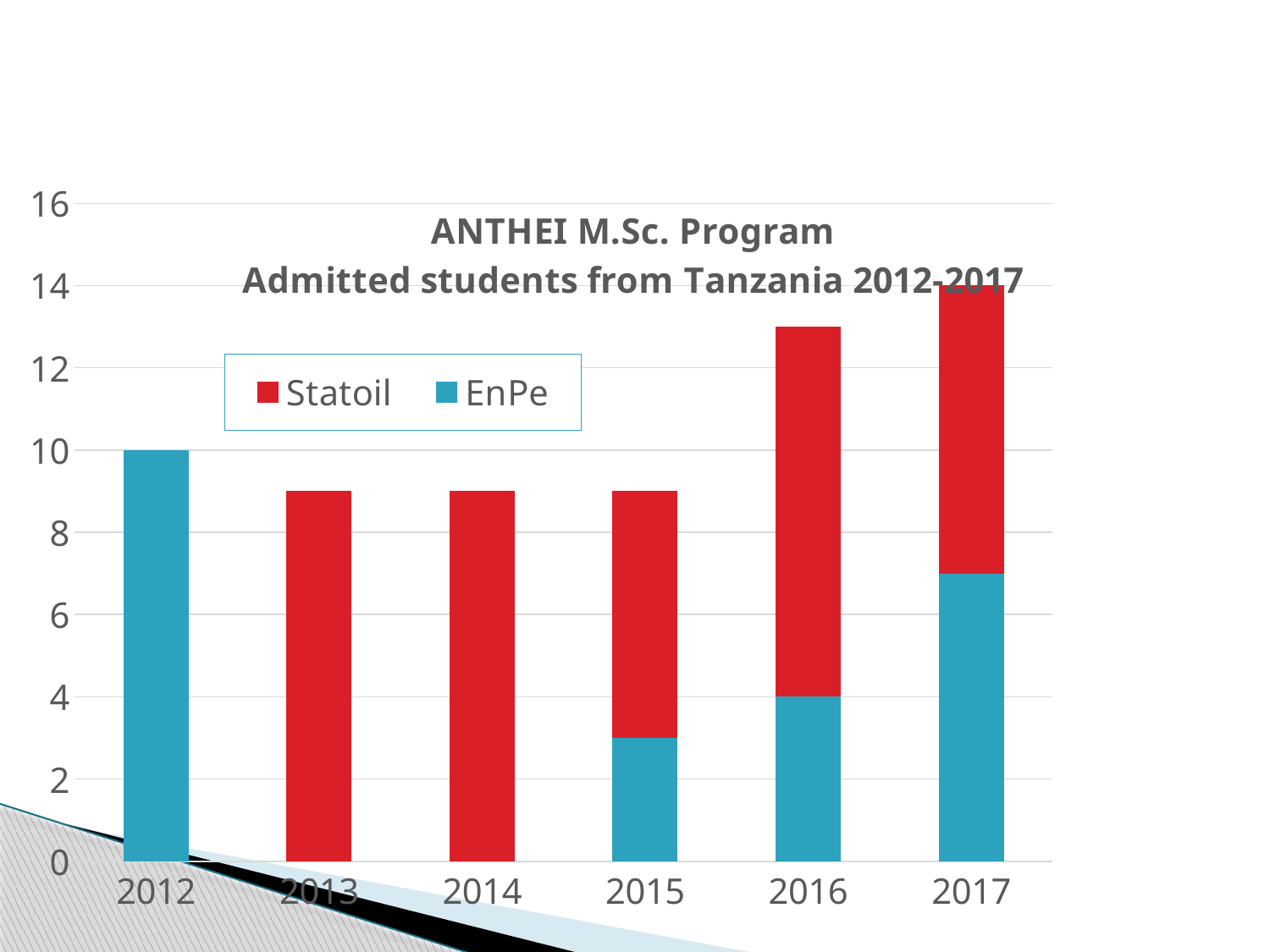
How many years are shown on the x axis? 6 What is the EnPe value for 2012? 10 Is the total for 2016 greater or less than 12? greater What kind of chart is shown on the slide? Stacked bar chart Which year has a larger total, 2015 or 2016? 2016 Which colour represents Statoil in the legend? Red Do the total admitted students rise or fall from 2015 to 2017? Rise What is the EnPe value for 2016? 4 How many series does the legend list? 2 What is the total height of the stacked bar for 2017? 14 Is the EnPe value for 2015 greater or less than 4? less Which year has the tallest stacked bar overall? 2017